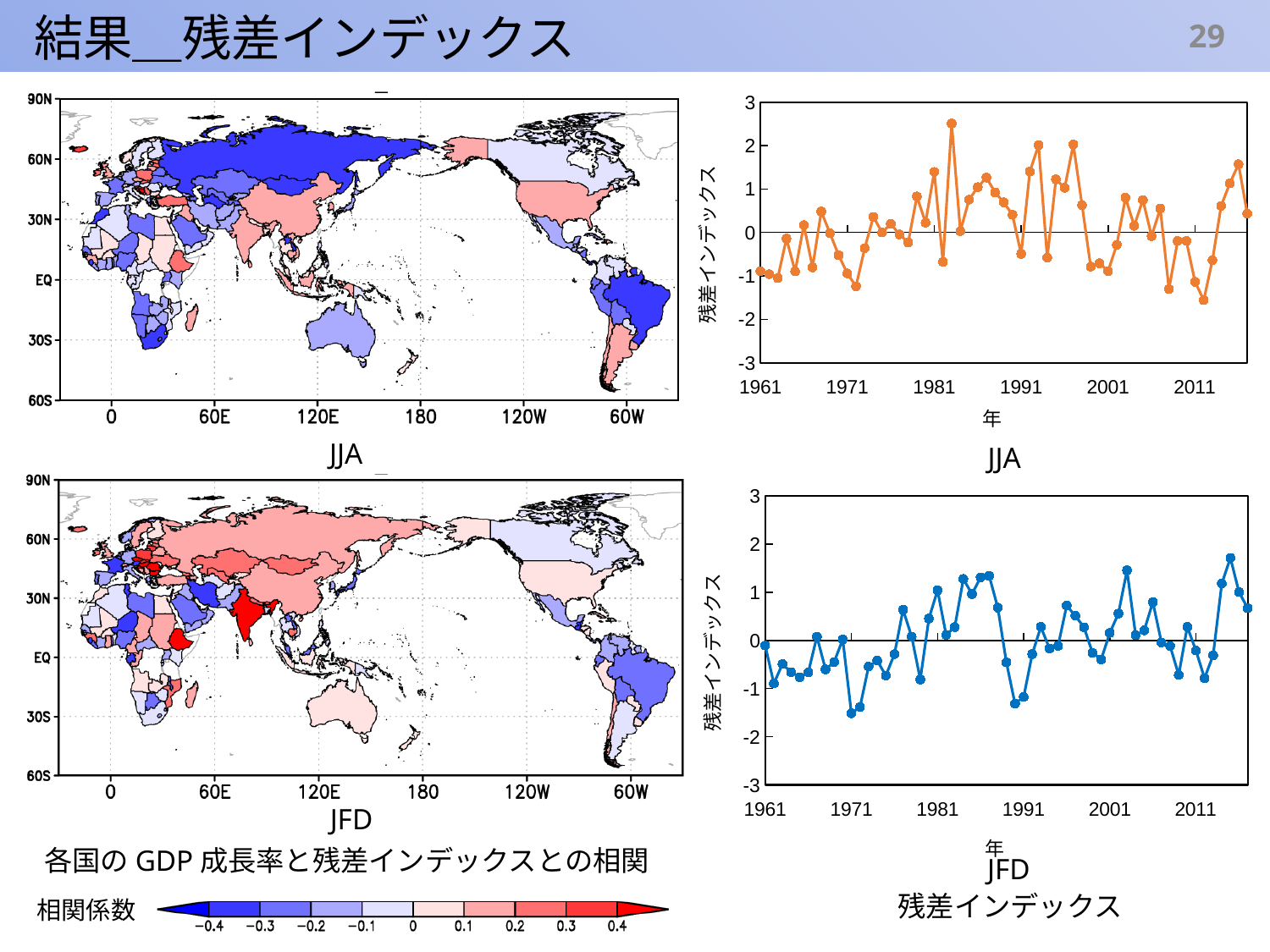
In the JJA line chart, is the highest value greater or less than 2? greater In the JJA line chart, is the value for 2011 greater or less than 0? less What kind of chart is the JJA chart on the right side of the slide? line chart In the JJA line chart, is the lowest value greater or less than -1? less What is the label on the x axis of the JJA line chart? 年 In the JFD line chart, what is the first year shown on the x axis? 1961 What is the label on the y axis of the JFD line chart? 残差インデックス In the JJA line chart, what is the highest value shown on the y axis? 3